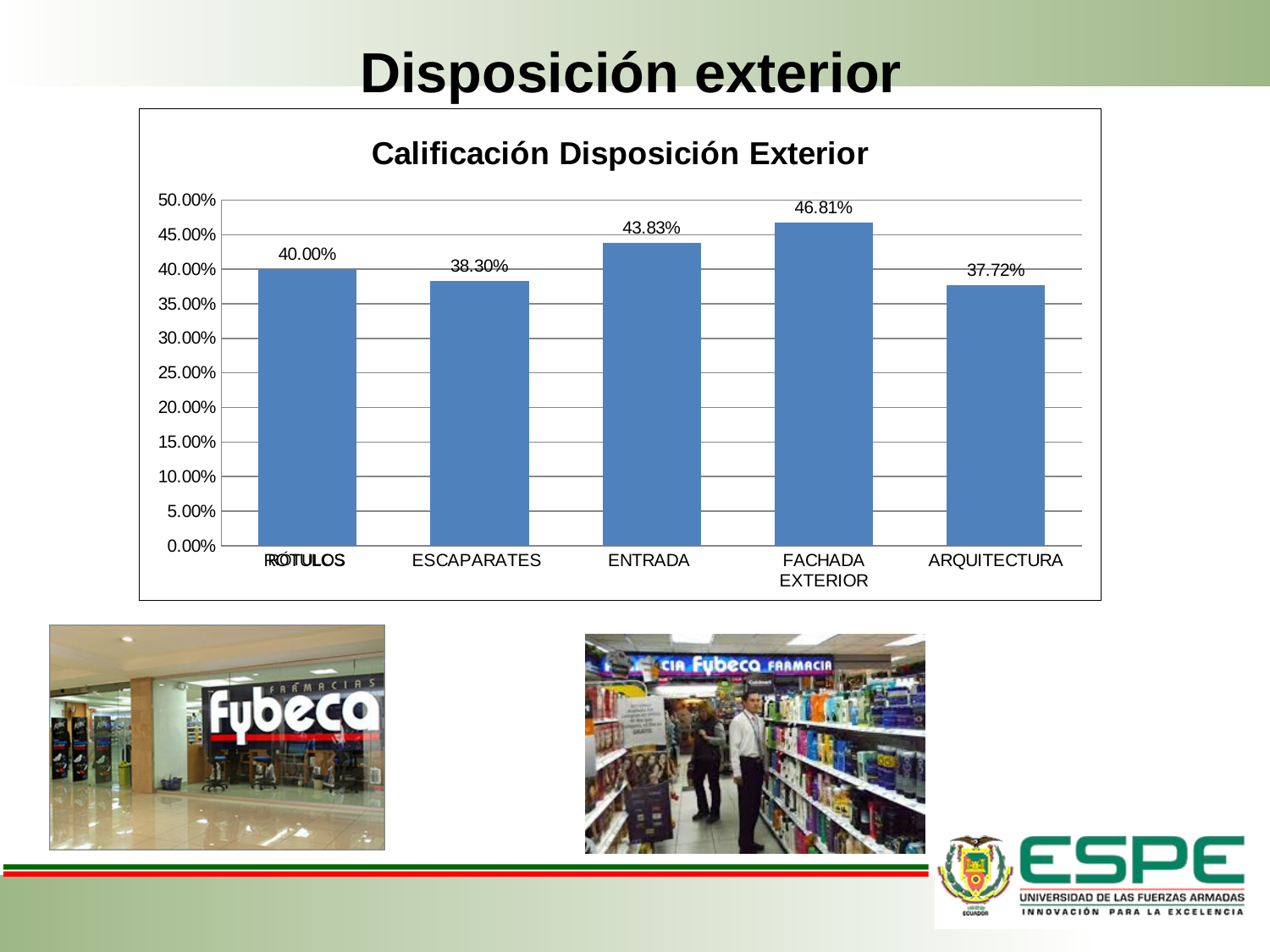
What is the value for ARQUITECTURA in the chart? 37.72% What is the title of the chart? Calificación Disposición Exterior Which category has the highest value in the chart? FACHADA EXTERIOR What is the value for FACHADA EXTERIOR in the chart? 46.81% What is the difference between the values for FACHADA EXTERIOR and ARQUITECTURA? 9.09% Which category has the lowest value in the chart? ARQUITECTURA What is the value for ESCAPARATES in the chart? 38.30% Which is larger, the value for ENTRADA or the value for RÓTULOS? ENTRADA What is the value for ENTRADA in the chart? 43.83% What kind of chart is shown on the slide? bar chart Is the value for ESCAPARATES greater or less than 40.00%? less How many categories are shown in the chart? 5